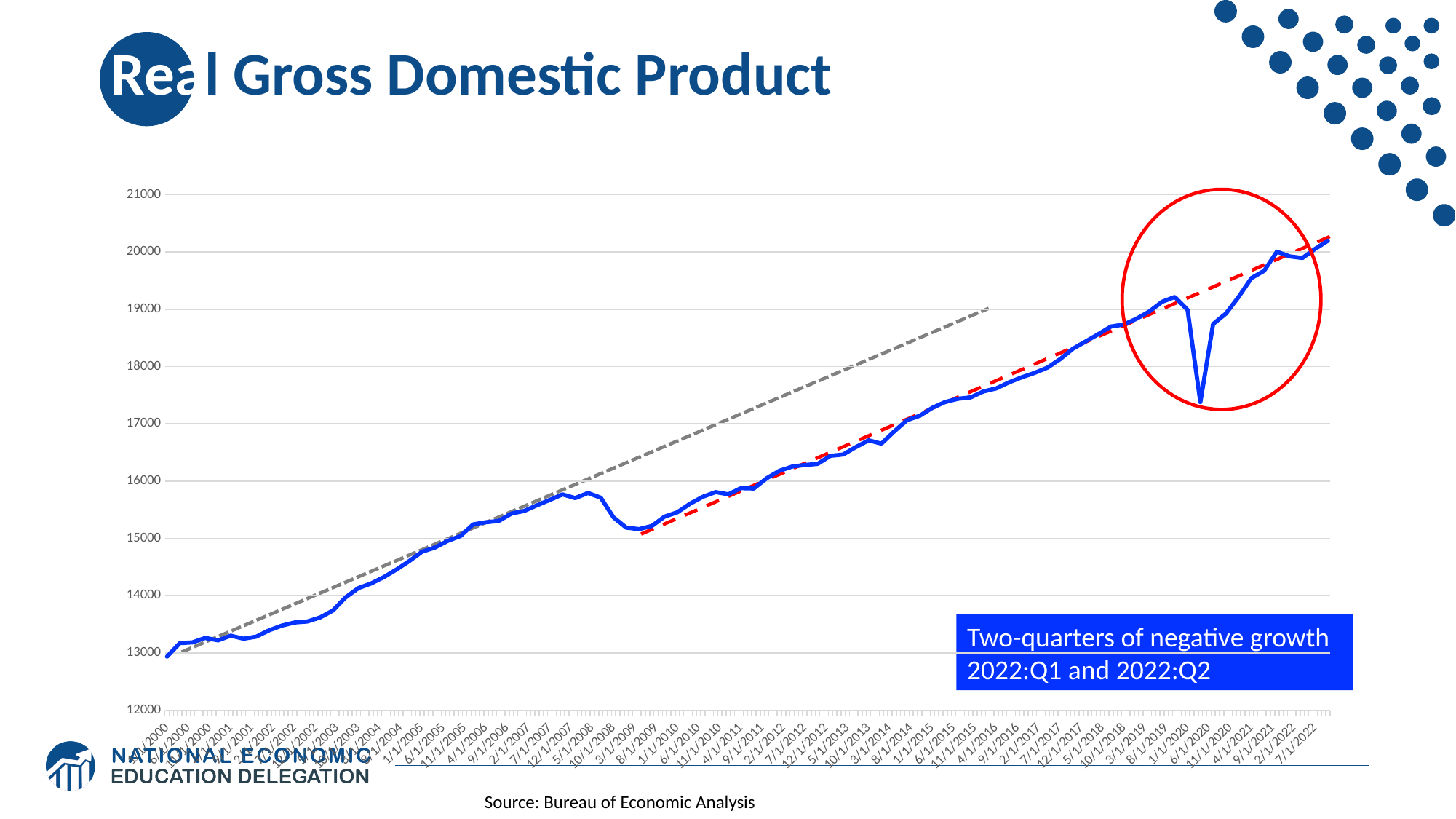
Is the value for 1/1/2015 greater or less than 18000? less Is the value for 8/1/2009 greater or less than 16000? less Is the value for 1/1/2000 greater or less than 14000? less Which is larger, the value for 1/1/2010 or the value for 1/1/2005? 1/1/2010 Do the values of the blue line generally rise or fall from 2000 to 2022? rise What is the title of the chart? Real Gross Domestic Product What source is cited for the chart? Bureau of Economic Analysis Which date on the x axis has the lowest value of the blue line? 1/1/2000 What kind of chart is shown on the slide? line chart